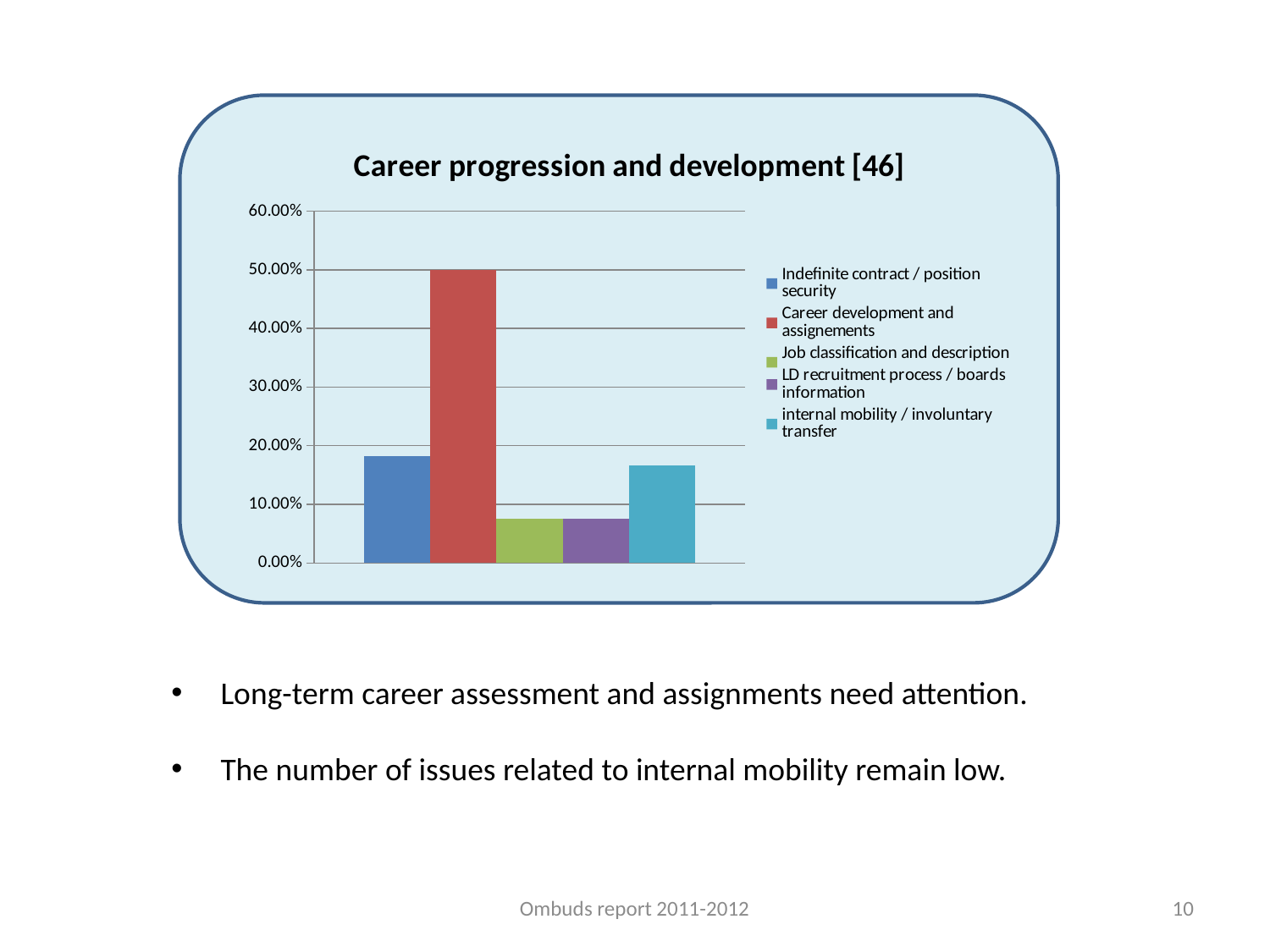
Is the value for Indefinite contract / position security greater or less than 20.00%? less Is the value for Indefinite contract / position security greater or less than 10.00%? greater What is the title of the chart? Career progression and development [46] How many entries does the chart's legend list? 5 Is the value for internal mobility / involuntary transfer greater or less than 20.00%? less What is the value for Career development and assignements? 50.00% Which category has the highest value in the chart? Career development and assignements What colour is the bar for Career development and assignements? red What kind of chart is shown on the slide? bar chart Which is larger: the value for Career development and assignements or the value for Indefinite contract / position security? Career development and assignements How many bars are plotted in the chart? 5